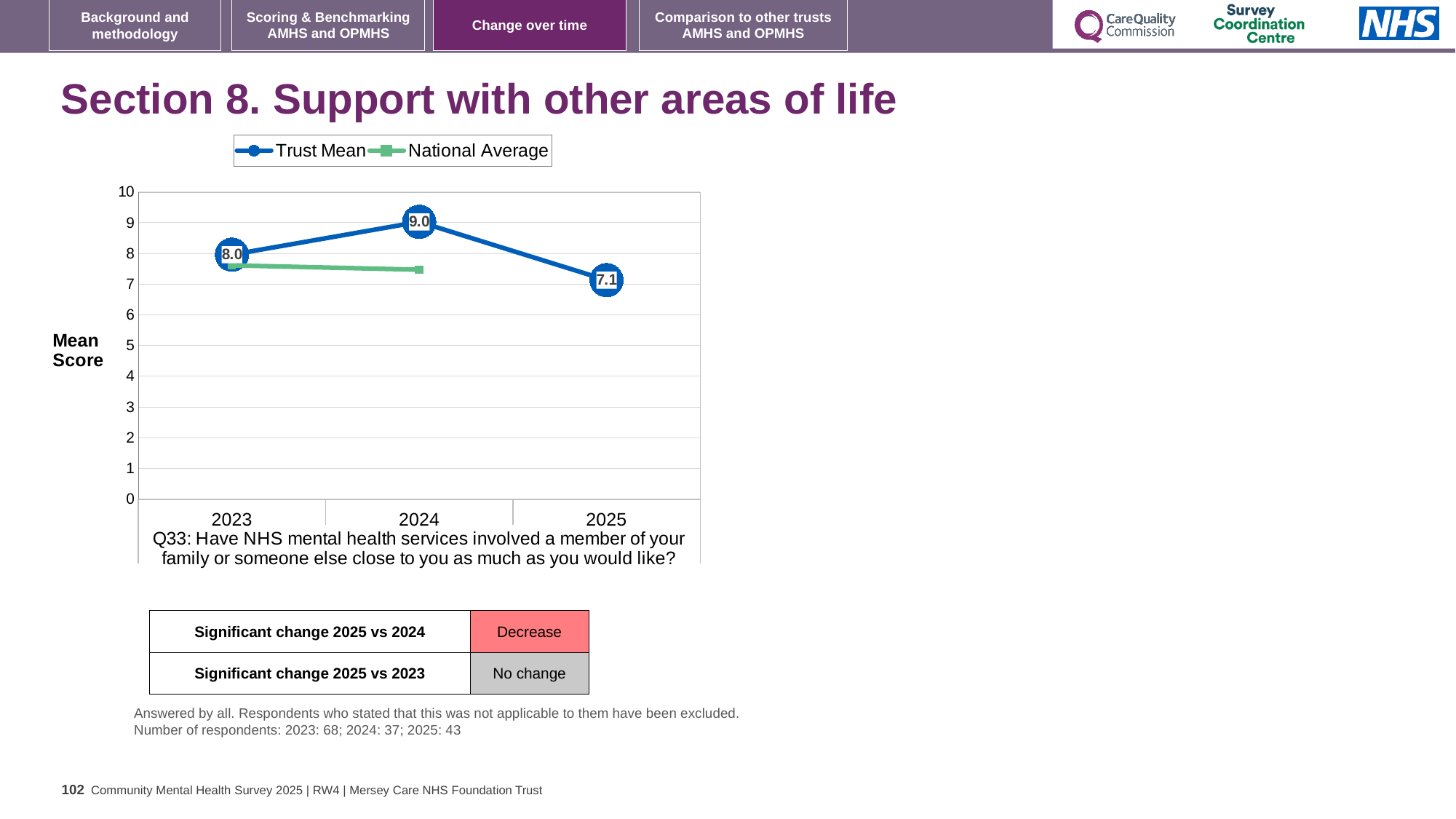
Does the Trust Mean rise or fall from 2024 to 2025? fall What is the Trust Mean score for 2023? 8.0 In which year is the Trust Mean highest? 2024 Is the National Average value for 2024 greater or less than 8? less What is the difference between the Trust Mean in 2024 and in 2025? 1.9 Which is larger in 2024, the Trust Mean or the National Average? Trust Mean What is the Trust Mean score for 2024? 9.0 What is the Trust Mean score for 2025? 7.1 What type of chart is shown on the slide? line chart In which year is the Trust Mean lowest? 2025 How many series does the legend list? 2 How many years are shown on the x axis? 3